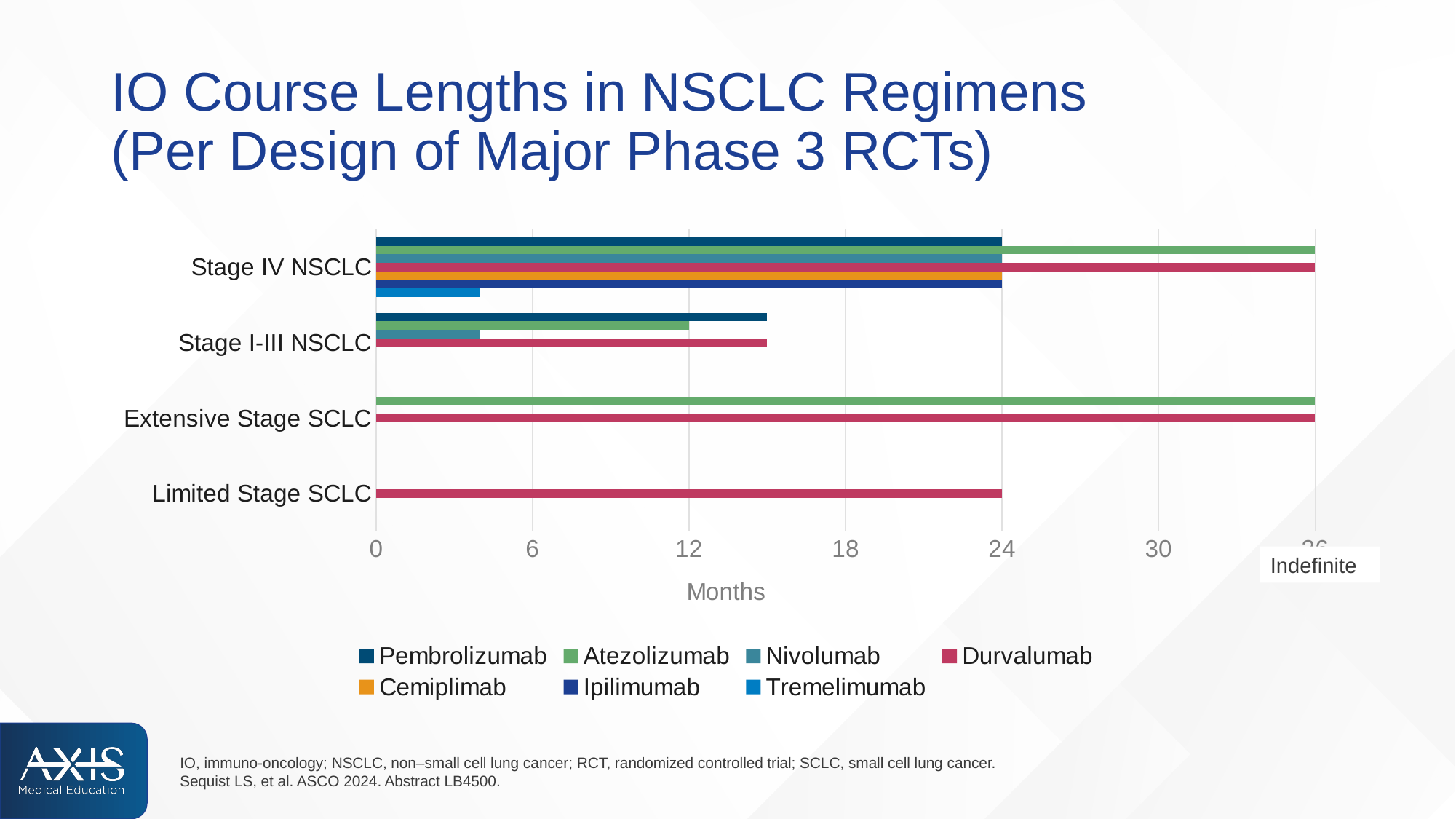
For Stage I-III NSCLC, which has the longer course length, Pembrolizumab or Atezolizumab? Pembrolizumab What is the difference in months between the Durvalumab course length for Limited Stage SCLC and the Atezolizumab course length for Stage I-III NSCLC? 12 How many months is the Atezolizumab course length for Stage I-III NSCLC? 12 Is the Tremelimumab course length for Stage IV NSCLC greater or less than 6 months? less What kind of chart is shown on the slide? bar chart What label is shown at the right end of the x axis, beyond the 36-month tick? Indefinite How many disease-stage categories are shown on the y axis of the chart? 4 How many months is the Durvalumab course length for Limited Stage SCLC? 24 Is the Pembrolizumab course length for Stage I-III NSCLC greater or less than 12 months? greater Is the Atezolizumab course length for Extensive Stage SCLC greater or less than 30 months? greater How many series does the chart's legend list? 7 How many months is the Pembrolizumab course length for Stage IV NSCLC? 24